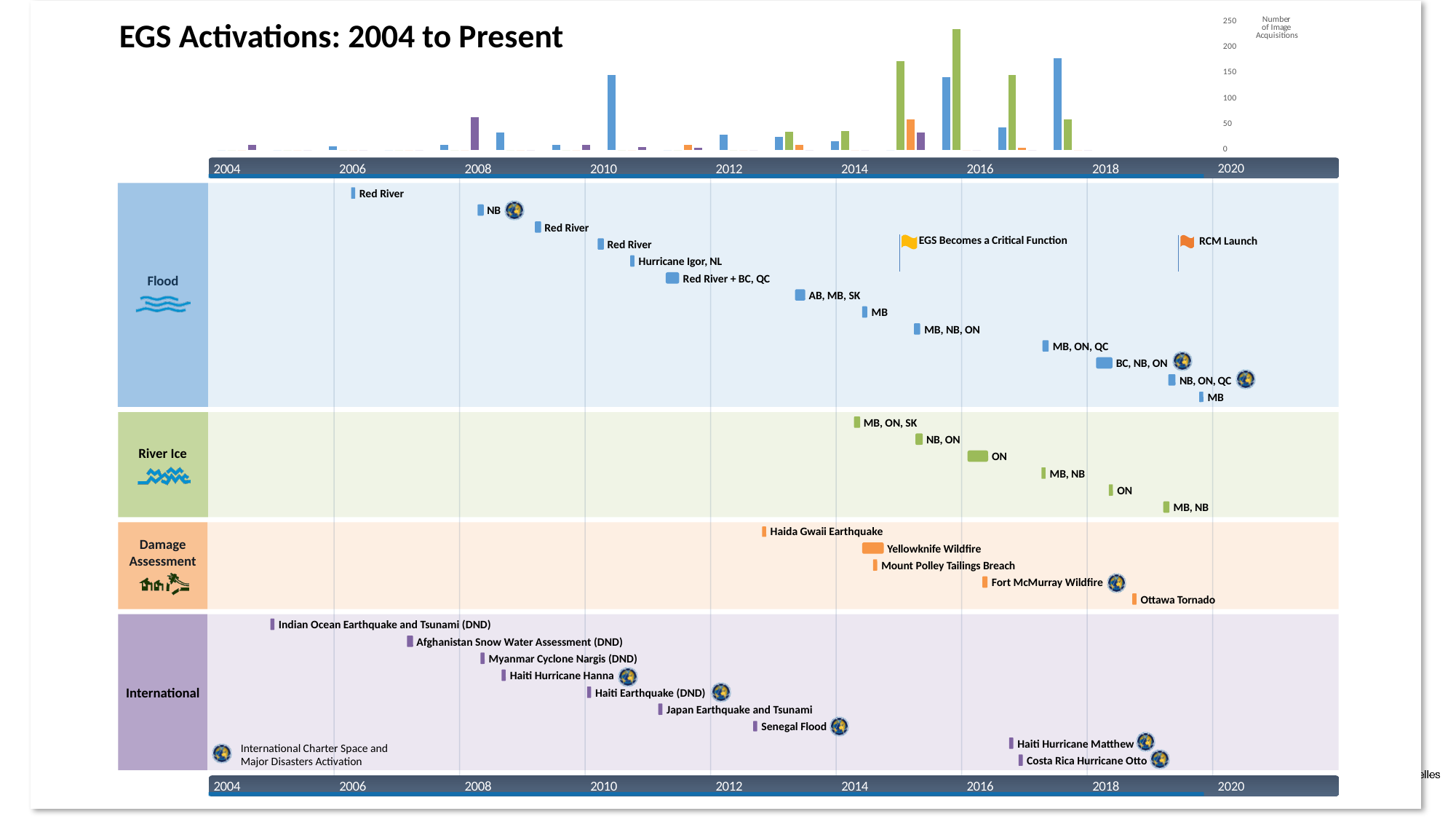
In the bar chart at the top of the slide, is the tallest blue bar near 2010 greater or less than 100? greater In the bar chart at the top of the slide, is the purple bar near 2008 greater or less than 100? less How many events are plotted in the River Ice row of the timeline? 6 What are the first and last years labelled on the timeline axis? 2004 and 2020 How many category rows does the timeline below the bar chart have? 4 What is the highest value shown on the vertical axis of the bar chart at the top of the slide? 250 What is the title of the slide? EGS Activations: 2004 to Present In the bar chart at the top of the slide, is the tallest bar greater or less than 200? greater In the bar chart at the top of the slide, which is taller: the tallest green bar or the tallest blue bar? the tallest green bar How many events are plotted in the Damage Assessment row of the timeline? 5 In the bar chart at the top of the slide, what colour is the tallest bar? green What kind of chart is shown at the top of the slide above the timeline? bar chart